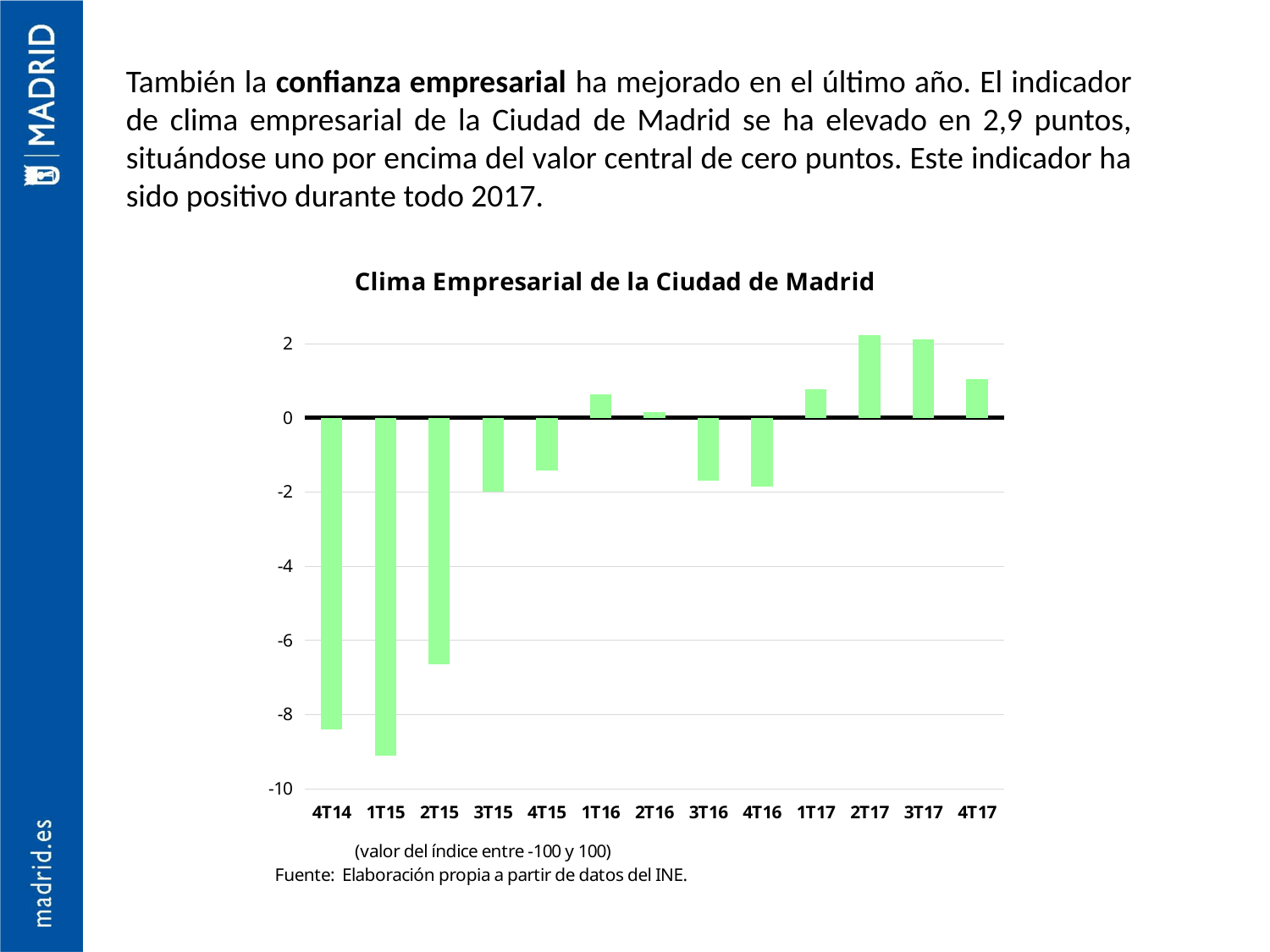
Do the values generally rise or fall from 4T14 to 4T17? rise Which has the larger value, 4T14 or 2T15? 2T15 Is the value for 4T14 greater or less than -8? less What kind of chart is shown on the slide? bar chart What is the title of the chart? Clima Empresarial de la Ciudad de Madrid Is the value for 4T17 greater or less than 0? greater Is the value for 2T17 greater or less than 2? greater Which quarter has the lowest value in the chart? 1T15 Which has the larger value, 1T16 or 3T16? 1T16 How many quarters are plotted on the x axis of the chart? 13